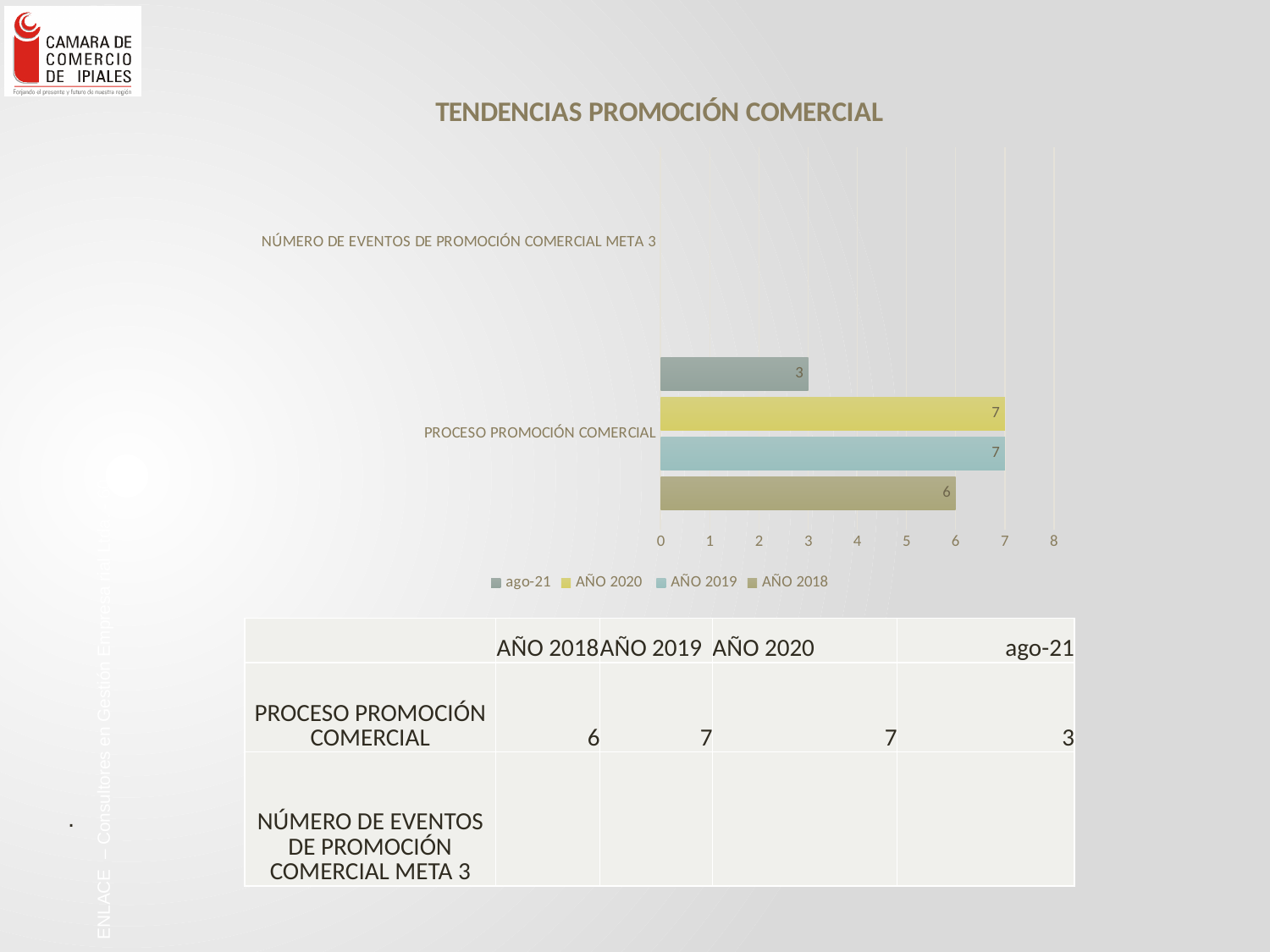
Which is larger for PROCESO PROMOCIÓN COMERCIAL, the AÑO 2018 value or the ago-21 value? AÑO 2018 What is the difference between the AÑO 2020 value and the ago-21 value for PROCESO PROMOCIÓN COMERCIAL? 4 What is the value for ago-21 in the PROCESO PROMOCIÓN COMERCIAL category? 3 Which series is shown in yellow in the chart? AÑO 2020 What is the value for AÑO 2019 in the PROCESO PROMOCIÓN COMERCIAL category? 7 How many series does the legend list? 4 What is the value for AÑO 2020 in the PROCESO PROMOCIÓN COMERCIAL category? 7 What is the title of the chart? TENDENCIAS PROMOCIÓN COMERCIAL What kind of chart is shown on the slide? Bar chart What is the difference between the AÑO 2019 value and the AÑO 2018 value for PROCESO PROMOCIÓN COMERCIAL? 1 Which series has the lowest value for PROCESO PROMOCIÓN COMERCIAL? ago-21 What is the value for AÑO 2018 in the PROCESO PROMOCIÓN COMERCIAL category? 6